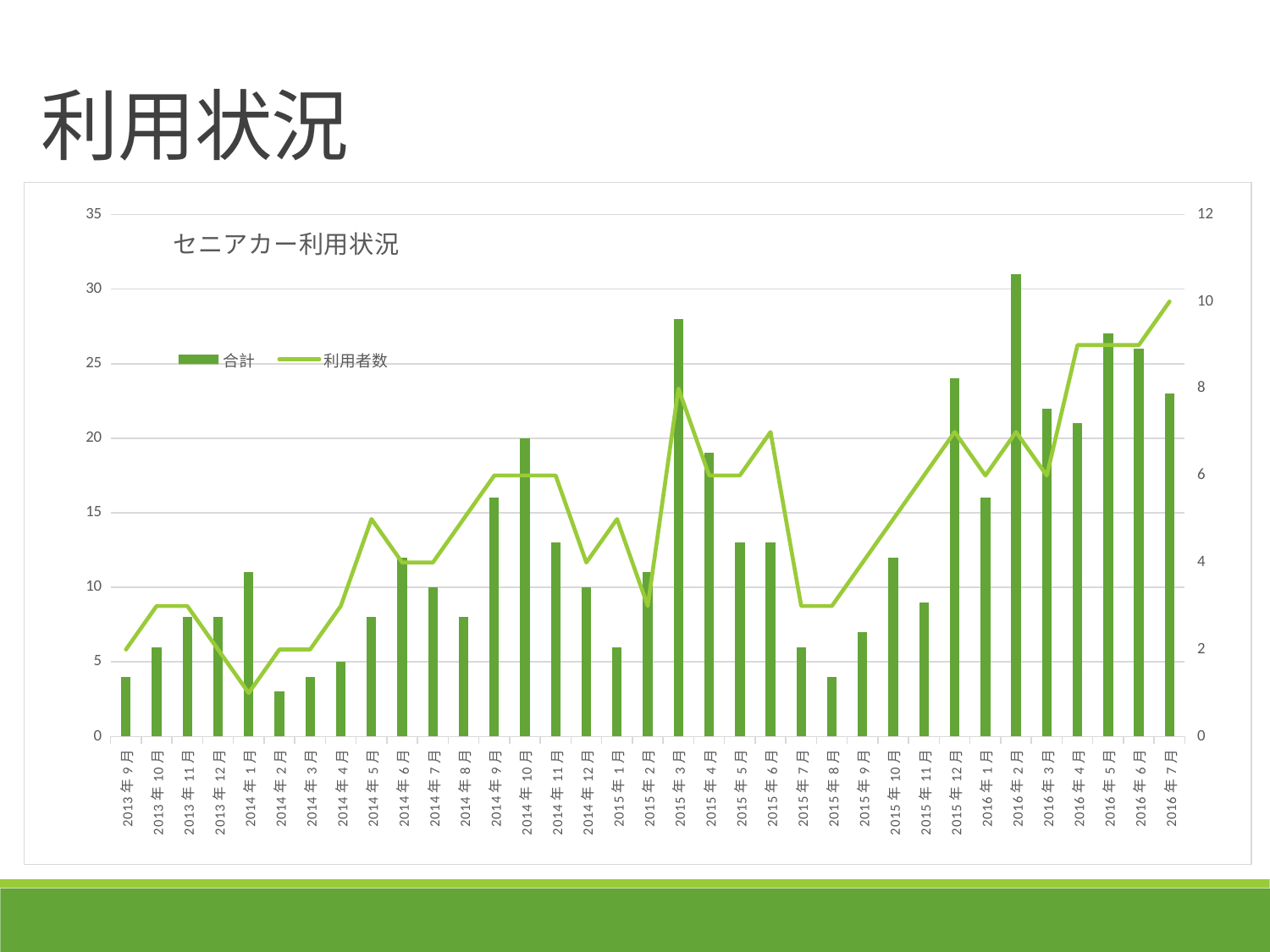
How many months (categories) are plotted along the x axis? 35 Is the 合計 value for 2014年2月 greater or less than 5? less Is the 合計 value for 2015年12月 greater or less than 20? greater What is the title of the chart? セニアカー利用状況 Is the 合計 value for 2016年2月 greater or less than 30? greater Which month has the highest 合計 bar? 2016年2月 How many series does the chart legend list? 2 Does the 利用者数 line rise or fall from 2016年3月 to 2016年7月? rise Which has the larger 合計 bar, 2015年3月 or 2015年4月? 2015年3月 Which series is drawn as a line in the chart? 利用者数 What kind of chart is shown on the slide? Combined bar and line chart